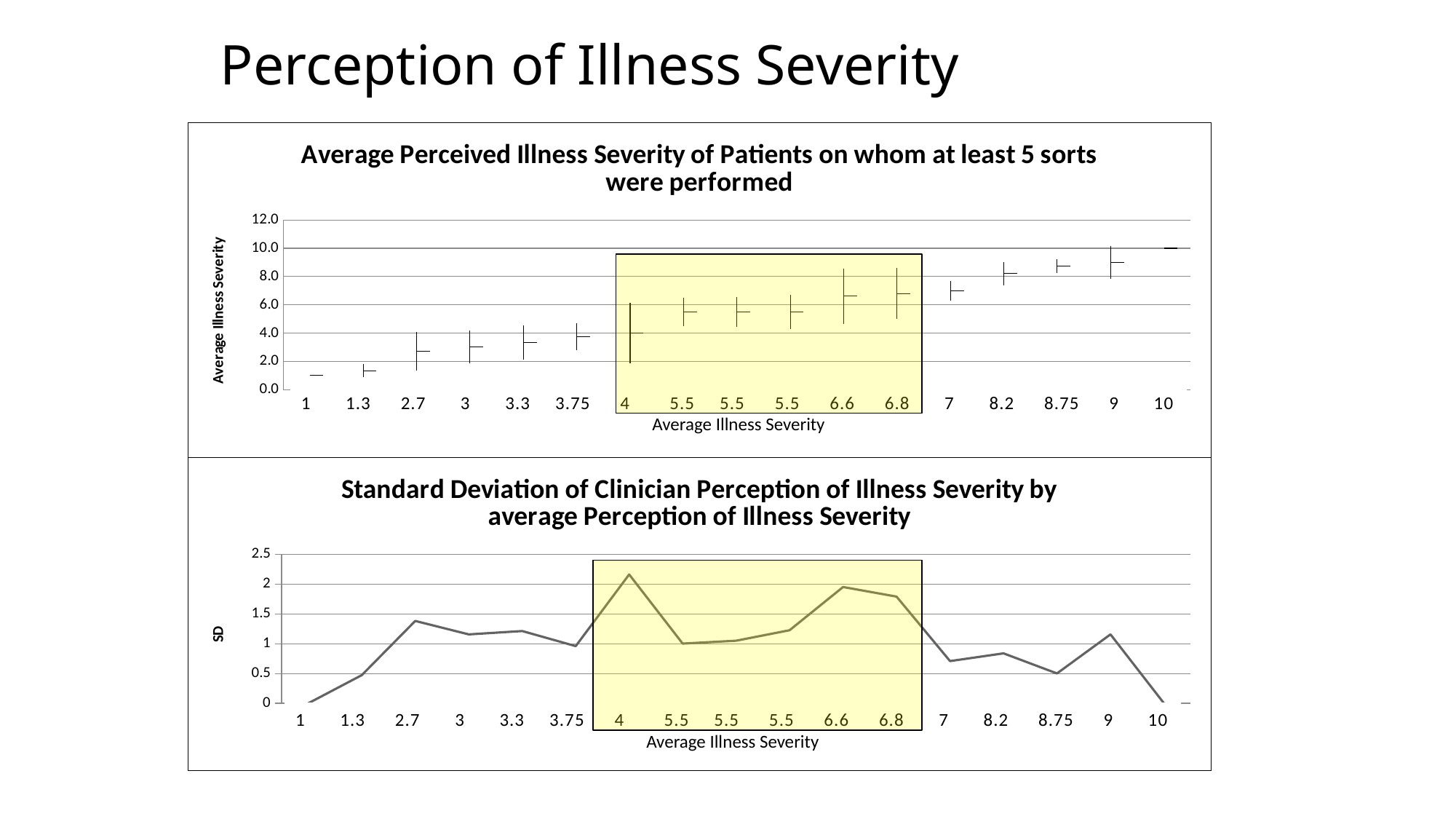
How many categories are shown on the x axis of the bottom chart (Standard Deviation of Clinician Perception)? 17 In the top chart (Average Perceived Illness Severity), is the average value for category 8.75 greater or less than 8.0? greater In the top chart (Average Perceived Illness Severity), do the average values generally rise or fall from left to right along the x axis? rise How many categories are shown on the x axis of the top chart (Average Perceived Illness Severity)? 17 In the bottom chart (Standard Deviation of Clinician Perception), which has the larger SD: category 4 or category 7? 4 What kind of chart is the bottom chart, 'Standard Deviation of Clinician Perception of Illness Severity by average Perception of Illness Severity'? line chart In the top chart (Average Perceived Illness Severity), is the average value for category 1.3 greater or less than 2.0? less What is the y-axis title of the bottom chart (Standard Deviation of Clinician Perception)? SD In the bottom chart (Standard Deviation of Clinician Perception), is the SD for category 4 greater or less than 2? greater In the bottom chart (Standard Deviation of Clinician Perception), which category has the highest SD? 4